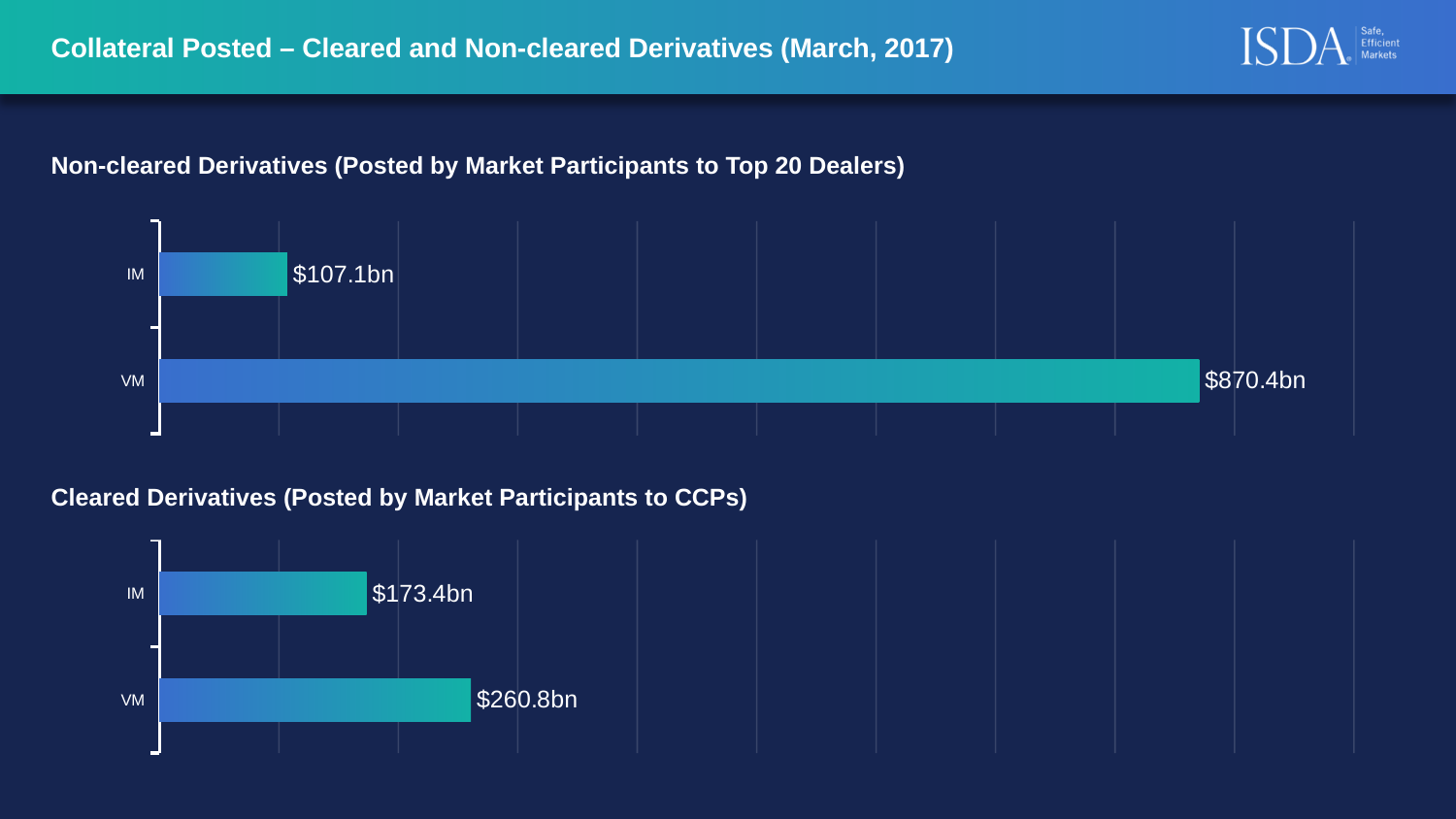
In the Non-cleared Derivatives chart, what is the value for VM? $870.4bn In the Cleared Derivatives chart, which category has the lowest value? IM Which is larger: the VM value in the Non-cleared Derivatives chart or the VM value in the Cleared Derivatives chart? Non-cleared Derivatives VM In the Non-cleared Derivatives chart, what is the difference between the VM and IM values? $763.3bn In the Cleared Derivatives chart, what is the value for IM? $173.4bn What type of chart is the Non-cleared Derivatives chart? Bar chart In the Non-cleared Derivatives chart, what is the value for IM? $107.1bn In the Non-cleared Derivatives chart, which category has the highest value? VM In the Cleared Derivatives chart, what is the difference between the VM and IM values? $87.4bn How many categories are shown in the Cleared Derivatives chart? 2 What is the title of the top chart on the slide? Non-cleared Derivatives (Posted by Market Participants to Top 20 Dealers) In the Cleared Derivatives chart, what is the value for VM? $260.8bn